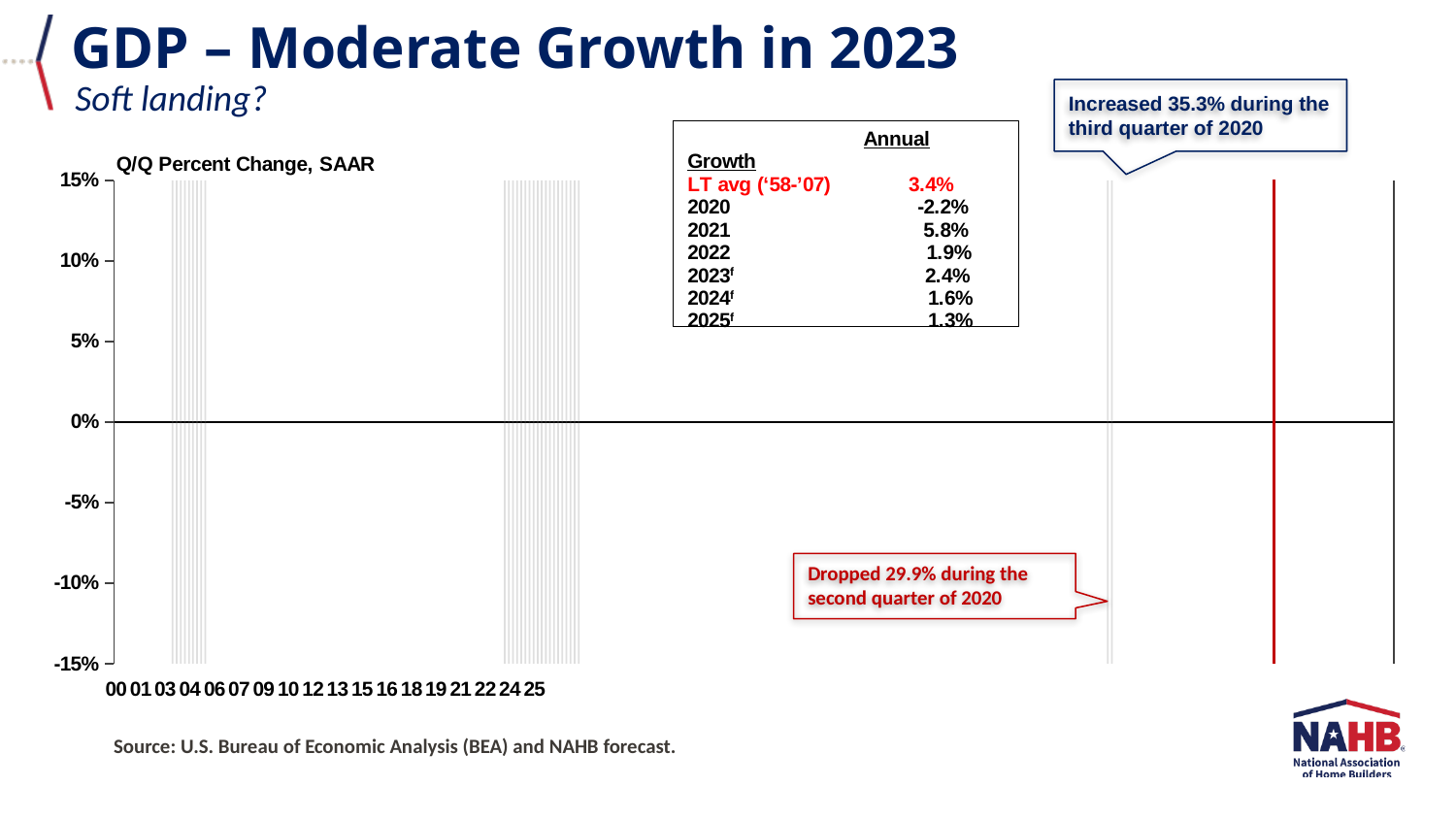
According to the annual growth table on the chart, what is the forecast GDP growth for 2023? 2.4% According to the callout on the chart, by how much did GDP increase during the third quarter of 2020? 35.3% What is the chart's title shown above the y axis? Q/Q Percent Change, SAAR According to the annual growth table on the chart, what is the long-term average ('58-'07) GDP growth? 3.4% In the annual growth table, which is larger: the 2022 growth or the 2024 forecast growth? 2022 In the annual growth table on the chart, which year has the lowest growth value? 2020 What is the difference between the 2021 growth and the 2022 growth in the annual table? 3.9% According to the annual growth table on the chart, what is the forecast GDP growth for 2025? 1.3% In the annual growth table on the chart, which year has the highest growth value? 2021 According to the annual growth table on the chart, what was GDP growth in 2020? -2.2% According to the callout on the chart, by how much did GDP drop during the second quarter of 2020? 29.9% According to the annual growth table on the chart, what was GDP growth in 2021? 5.8%